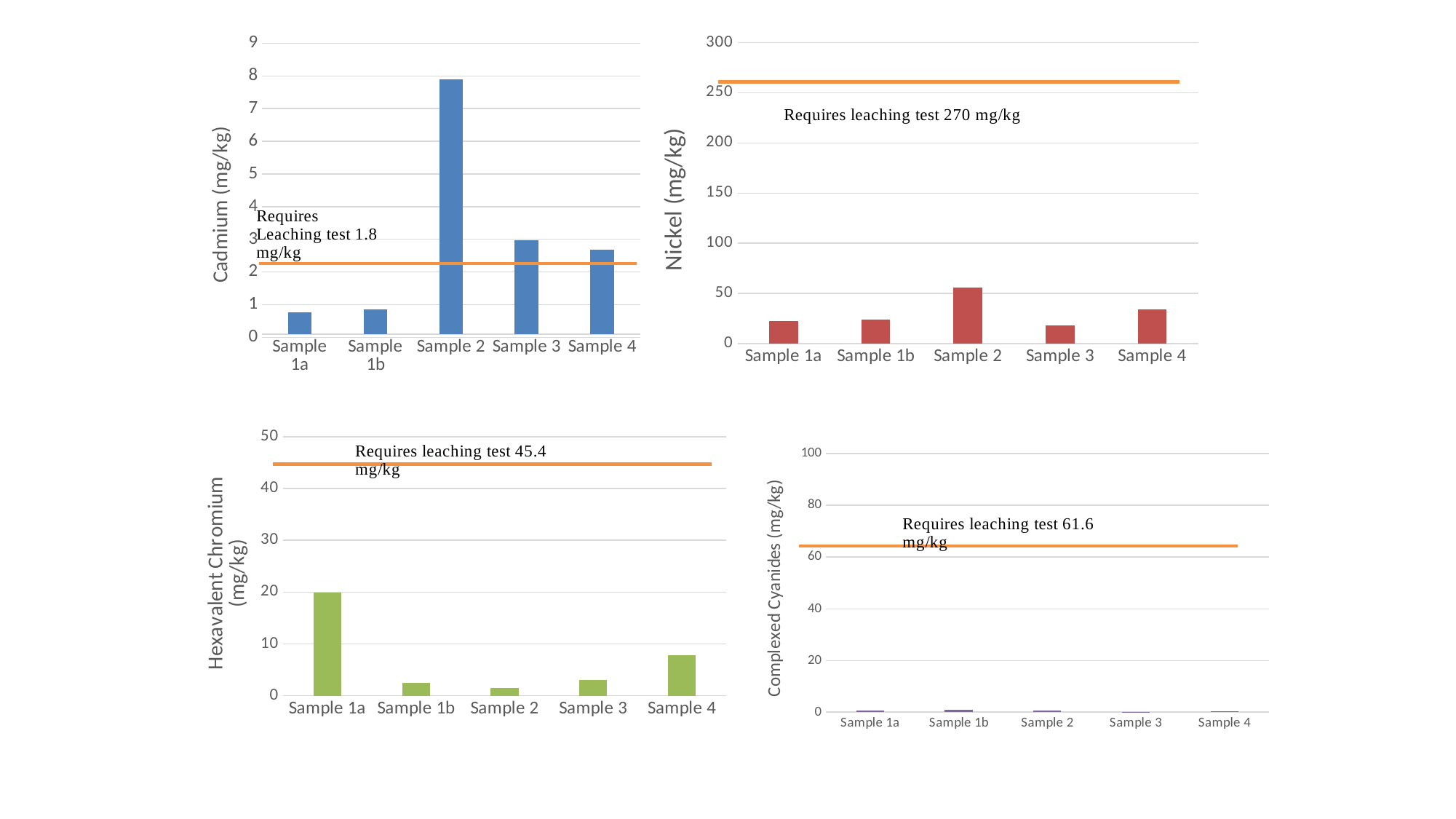
How many samples are shown on the x axis of the Nickel (mg/kg) chart at the top right? 5 In the Cadmium (mg/kg) chart at the top left, which sample has the highest value? Sample 2 In the Nickel (mg/kg) chart at the top right, which is larger, the value for Sample 4 or the value for Sample 1a? Sample 4 In the Hexavalent Chromium (mg/kg) chart at the bottom left, which sample has the highest value? Sample 1a In the Nickel (mg/kg) chart at the top right, which sample has the highest value? Sample 2 In the Nickel (mg/kg) chart at the top right, is the value for Sample 2 greater or less than 50? greater What kind of chart is the Hexavalent Chromium (mg/kg) chart at the bottom left? bar chart In the Cadmium (mg/kg) chart at the top left, is the value for Sample 2 greater or less than 7? greater In the Complexed Cyanides (mg/kg) chart at the bottom right, what threshold does the orange line's label say requires a leaching test? 61.6 mg/kg In the Hexavalent Chromium (mg/kg) chart at the bottom left, is the value for Sample 4 greater or less than 10? less In the Cadmium (mg/kg) chart at the top left, which is larger, the value for Sample 2 or the value for Sample 3? Sample 2